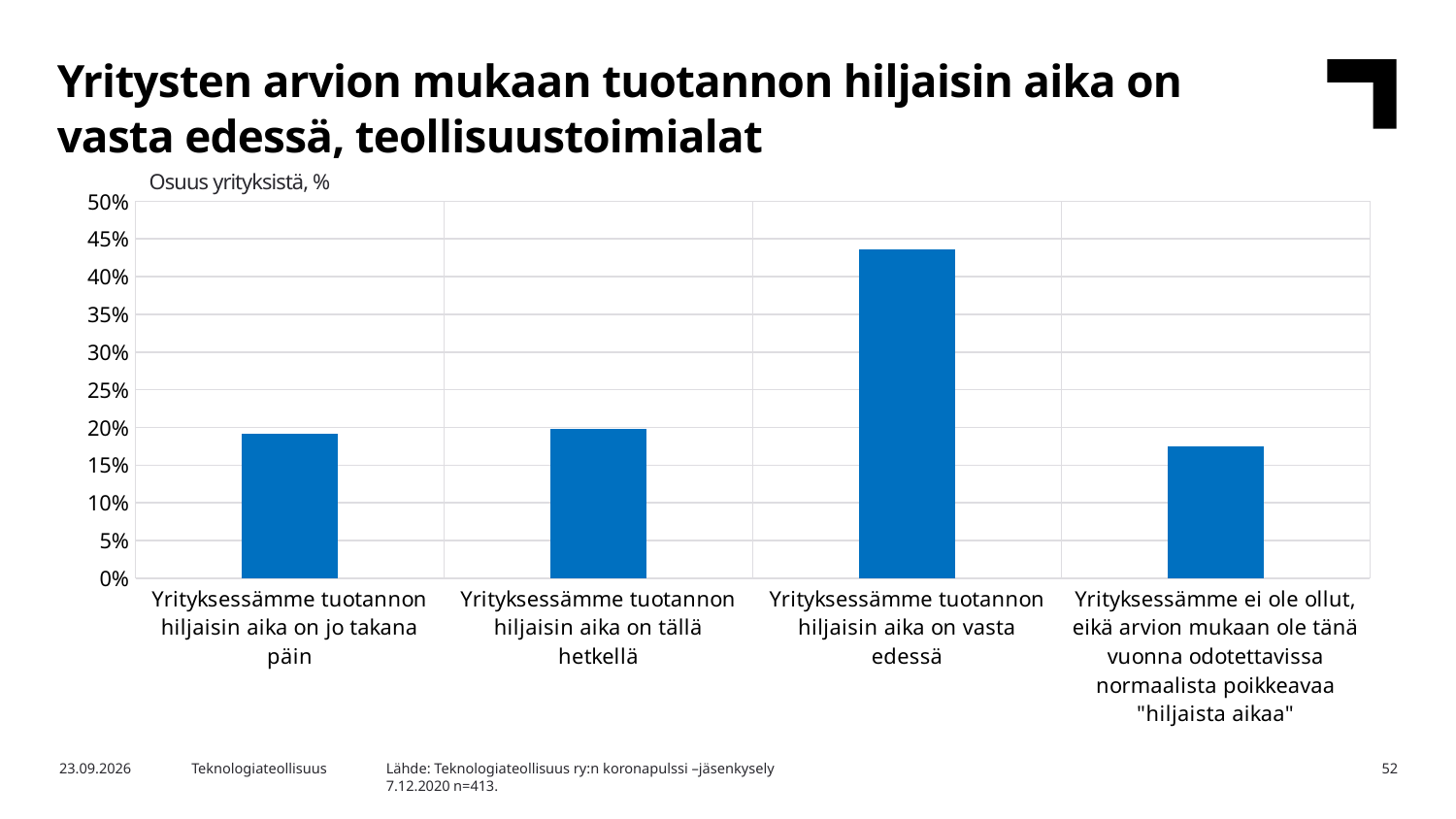
Is the value for "Yrityksessämme tuotannon hiljaisin aika on vasta edessä" greater or less than 40%? greater Is the value for "Yrityksessämme ei ole ollut, eikä arvion mukaan ole tänä vuonna odotettavissa normaalista poikkeavaa 'hiljaista aikaa'" greater or less than 20%? less Is the value for "Yrityksessämme tuotannon hiljaisin aika on jo takana päin" greater or less than 20%? less Which is larger: the value for "Yrityksessämme tuotannon hiljaisin aika on vasta edessä" or the value for "Yrityksessämme tuotannon hiljaisin aika on tällä hetkellä"? Yrityksessämme tuotannon hiljaisin aika on vasta edessä What is the highest value shown on the vertical axis of the chart? 50% Which category has the highest value in the chart? Yrityksessämme tuotannon hiljaisin aika on vasta edessä How many categories are shown on the x axis of the chart? 4 What kind of chart is shown on the slide? bar chart What is the label shown above the vertical axis of the chart? Osuus yrityksistä, %